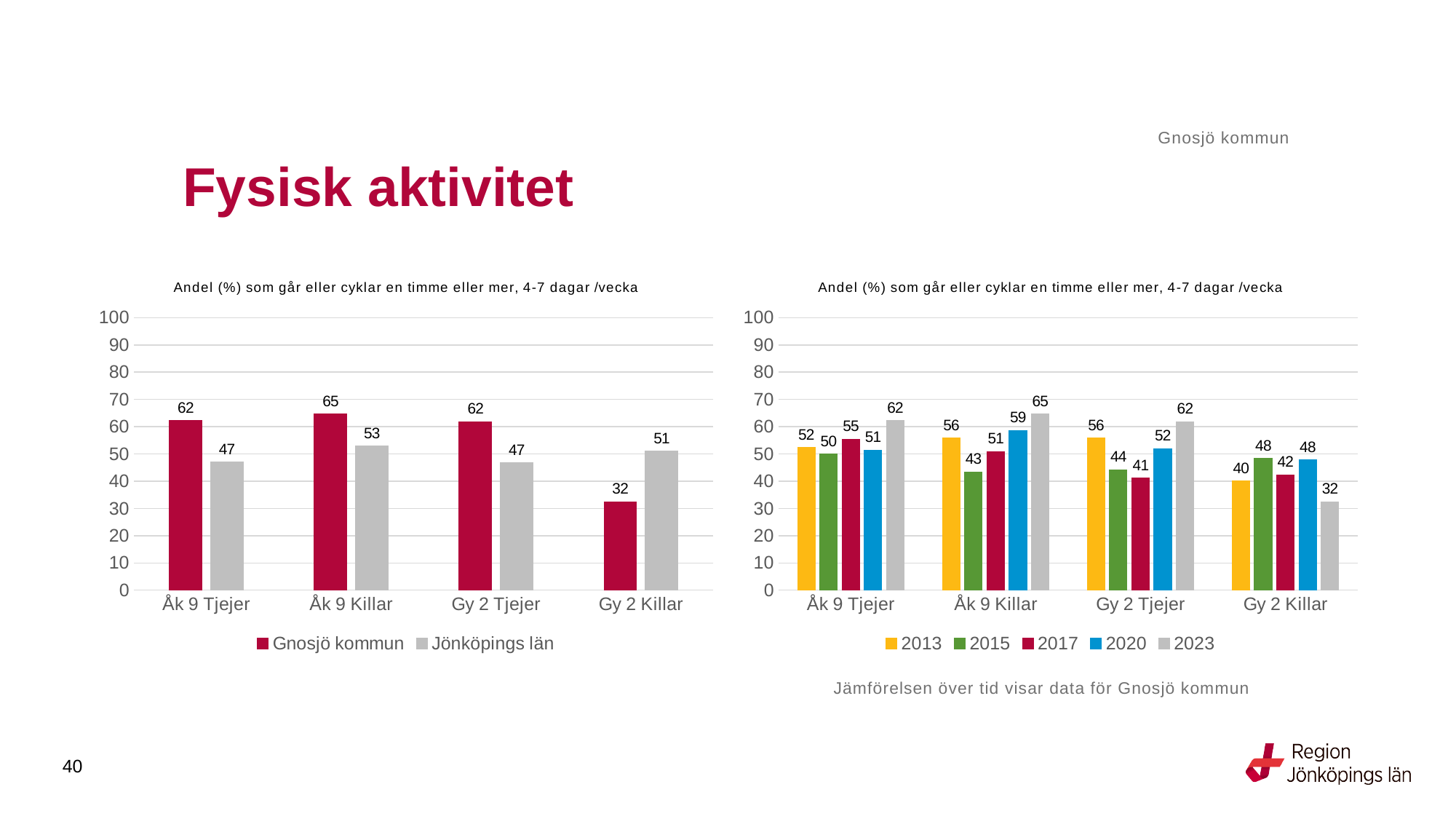
In the left chart, what is the difference between Gnosjö kommun and Jönköpings län for Åk 9 Tjejer? 15 What type of chart is the right chart? Bar chart How many series does the legend of the left chart list? 2 In the right chart, what is the difference between 2023 and 2013 for Åk 9 Tjejer? 10 In the left chart, what is the value for Gnosjö kommun for Gy 2 Killar? 32 In the right chart, what is the value for 2017 for Gy 2 Tjejer? 41 In the left chart, what is the value for Jönköpings län for Åk 9 Killar? 53 In the left chart, which is larger for Gy 2 Killar: Gnosjö kommun or Jönköpings län? Jönköpings län In the right chart, what is the value for 2020 for Åk 9 Killar? 59 How many series does the legend of the right chart list? 5 In the right chart, which year has the lowest value for Gy 2 Killar? 2023 In the left chart, which category has the highest value for Gnosjö kommun? Åk 9 Killar